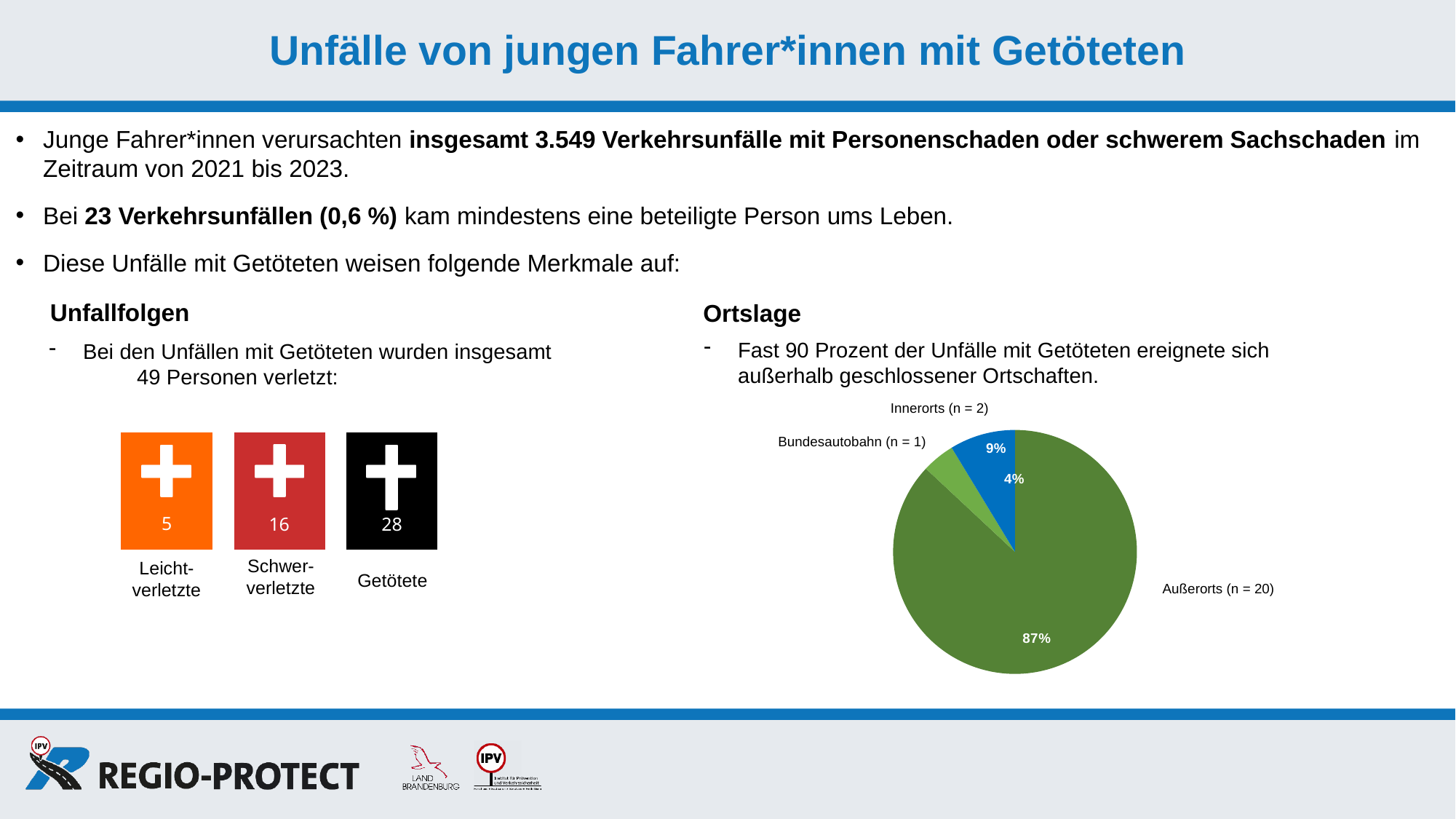
In the Ortslage pie chart, how many slices are there? 3 In the Ortslage pie chart, what colour is the Innerorts slice? blue In the Ortslage pie chart, how many accidents (n) occurred Innerorts? 2 In the Ortslage pie chart, what share of the accidents occurred on the Bundesautobahn? 4% In the Ortslage pie chart, how many accidents (n) occurred Außerorts? 20 In the Ortslage pie chart, what share of the accidents occurred Innerorts? 9% In the Ortslage pie chart, what is the difference in percentage points between the Außerorts and Innerorts shares? 78 In the Ortslage pie chart, which category has the largest slice? Außerorts (n = 20) In the Ortslage pie chart, what share of the accidents occurred Außerorts? 87% In the Ortslage pie chart, which category has the smallest slice? Bundesautobahn (n = 1) In the Ortslage pie chart, which is larger: the Innerorts share or the Bundesautobahn share? Innerorts What kind of chart is shown under the heading "Ortslage"? pie chart